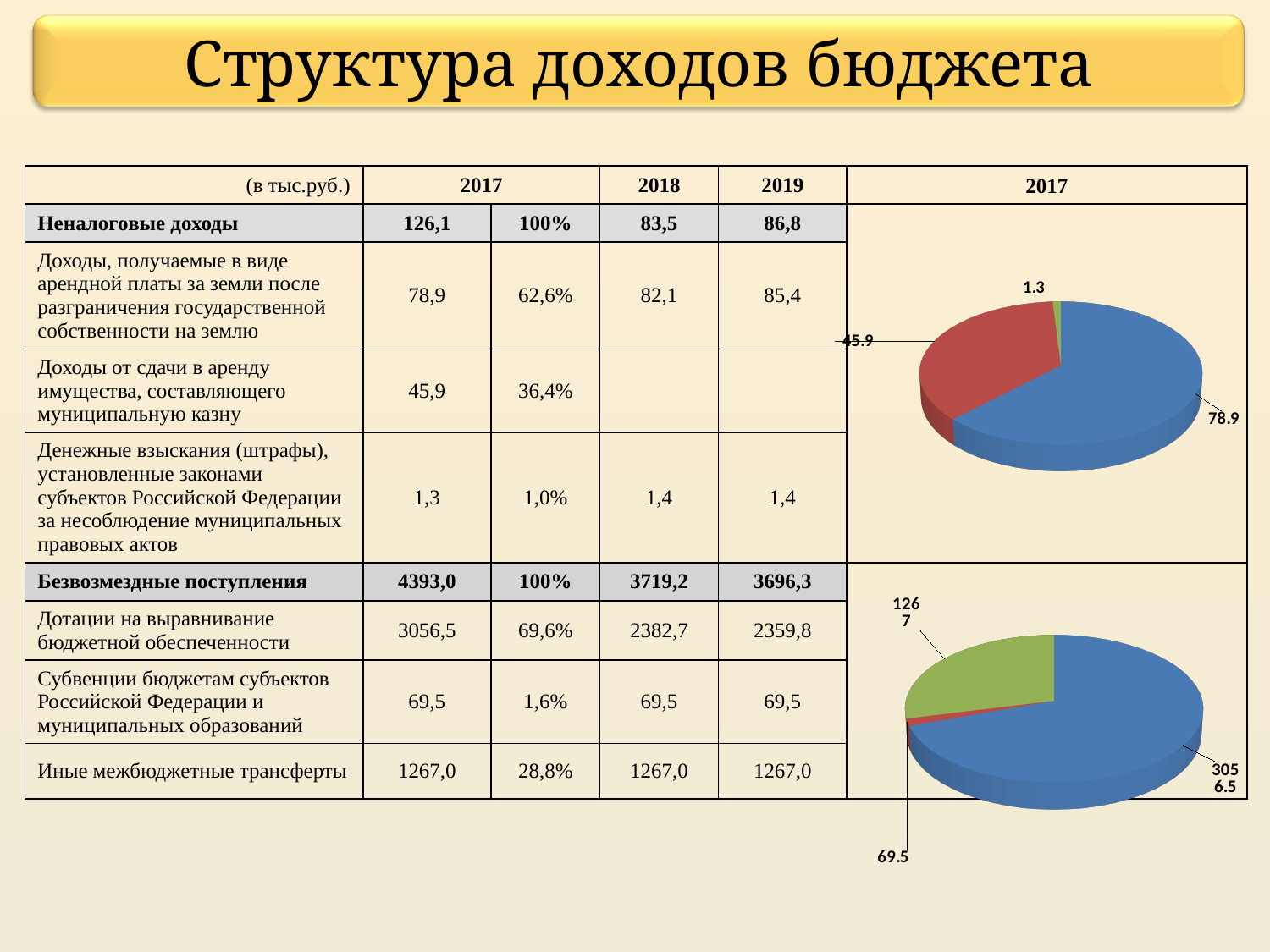
How many slices does the bottom pie chart have? 3 In the top pie chart, what is the difference between the 78.9 slice and the 45.9 slice? 33 How many pie charts are shown on the slide? 2 How many slices does the top pie chart have? 3 In the top pie chart, what colour is the largest slice? blue What kind of chart is the top chart on the right side of the slide? pie chart In the bottom pie chart, what is the value of the smallest slice? 69.5 What is the total of all slice values in the top pie chart? 126.1 In the top pie chart, what is the value of the largest slice? 78.9 In the bottom pie chart, what is the value of the largest slice? 3056.5 What is the total of all slice values in the bottom pie chart? 4393 In the top pie chart, what is the value of the smallest slice? 1.3